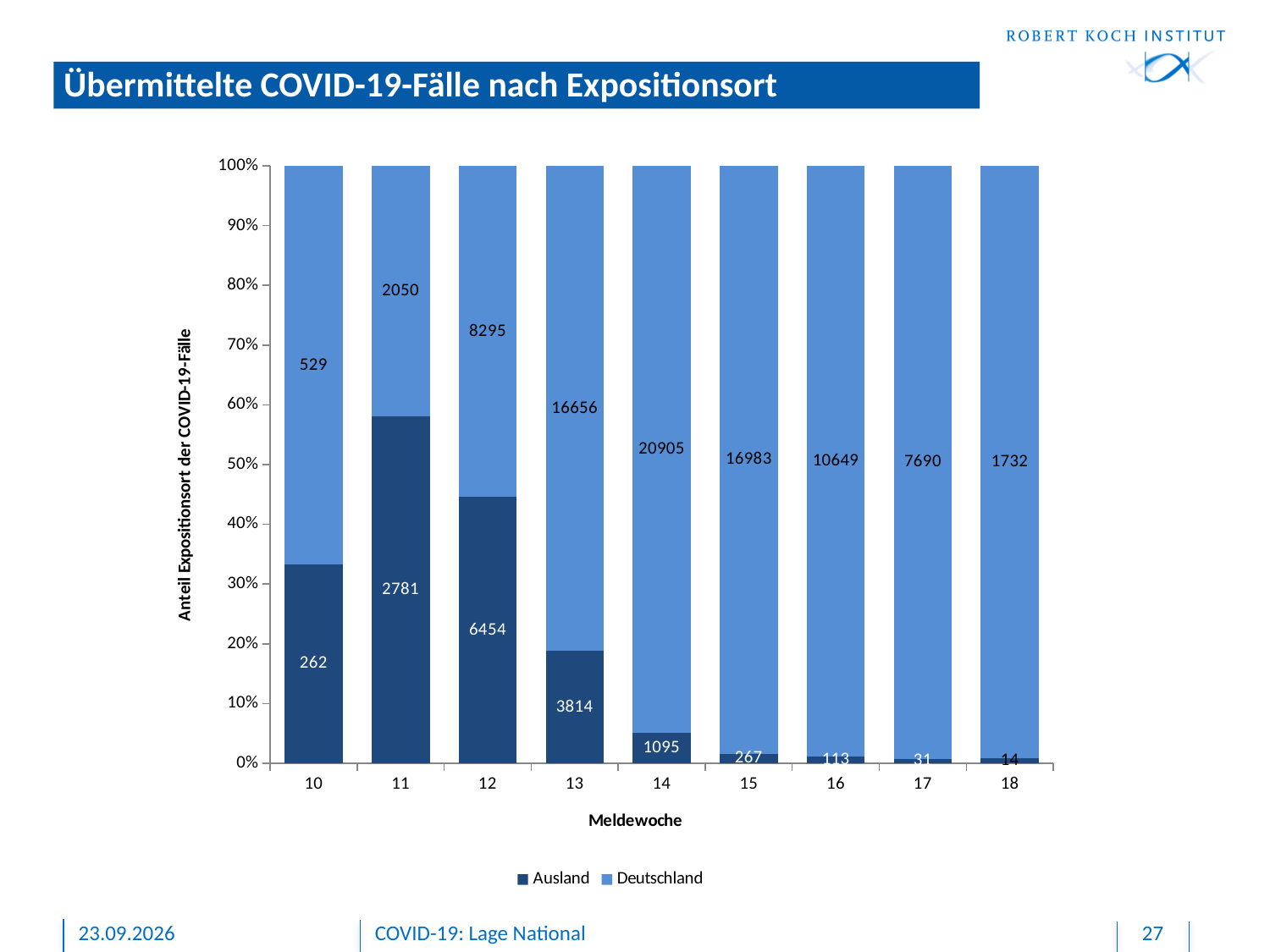
What is the difference between the Deutschland values for Meldewoche 13 and Meldewoche 12? 8361 What is the Deutschland value for Meldewoche 14? 20905 Which Meldewoche has the lowest Ausland value? 18 Which Meldewoche has the highest Deutschland value? 14 What kind of chart is shown on the slide? stacked bar chart What is the Ausland value for Meldewoche 12? 6454 How many series does the legend list? 2 Which is larger, the Ausland value for Meldewoche 11 or the Ausland value for Meldewoche 13? Meldewoche 13 What is the Ausland value for Meldewoche 18? 14 How many Meldewochen are shown on the x axis? 9 Is the Ausland share of the bar for Meldewoche 11 greater or less than 50%? greater What is the total of the Ausland and Deutschland values for Meldewoche 10? 791